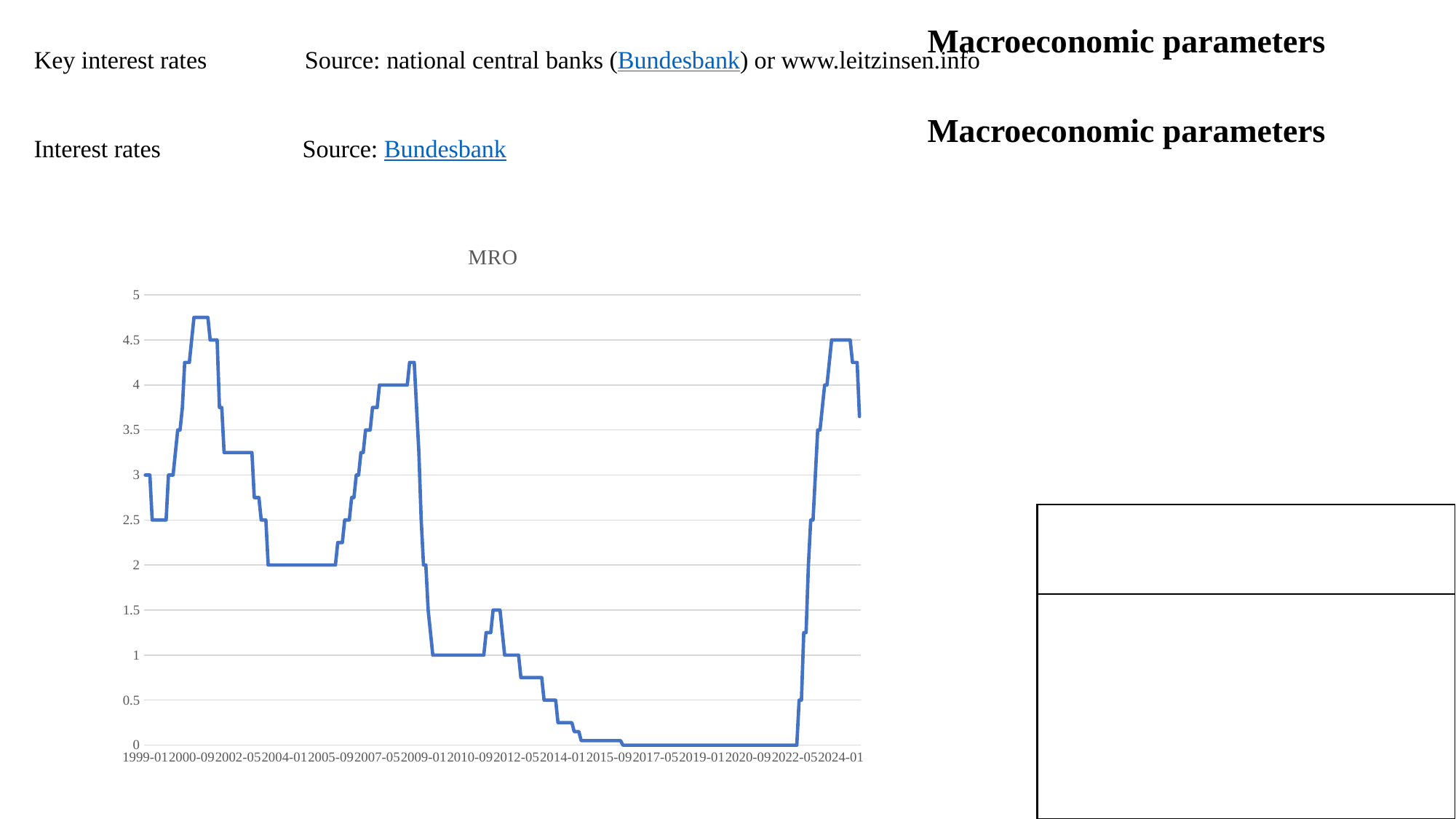
What is the title of the chart on the slide? MRO What kind of chart is the MRO chart? line chart What is the highest value shown on the y axis of the MRO chart? 5 In the MRO chart, is the value at 2017-05 greater or less than 0.5? less In the MRO chart, is the value at 2004-01 greater or less than 2.5? less In the MRO chart, is the value at 2024-01 greater or less than 4? greater In the MRO chart, does the value rise or fall between 2022-05 and 2024-01? rise In the MRO chart, does the value rise or fall between 2009-01 and 2015-09? fall In the MRO chart, which is larger, the value at 2024-01 or the value at 2019-01? 2024-01